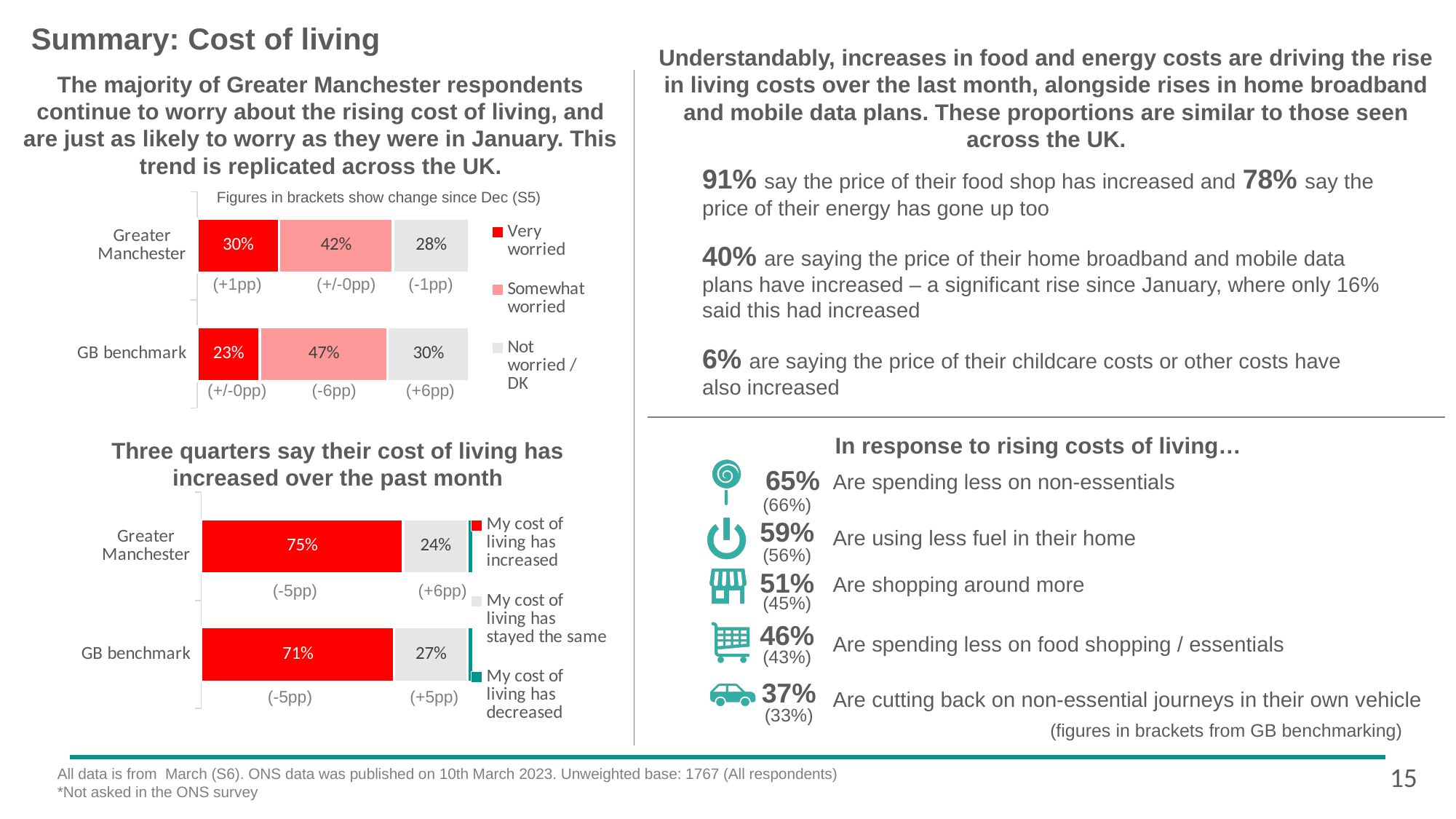
In the bottom-left chart on cost of living increasing over the past month, what is the difference between the 'increased' values for Greater Manchester and the GB benchmark? 4 percentage points In the bottom-left chart on cost of living increasing over the past month, what percentage of Greater Manchester respondents say their cost of living has increased? 75% In the top-left chart on worry about the cost of living, how many series does the legend list? 3 In the top-left chart on worry about the cost of living, what is the total of the Greater Manchester stacked bar? 100% In the top-left chart on worry about the cost of living, what is the difference between the very worried values for Greater Manchester and the GB benchmark? 7 percentage points In the top-left chart on worry about the cost of living, what percentage of Greater Manchester respondents are very worried? 30% In the bottom-left chart on cost of living increasing over the past month, what percentage of the GB benchmark say their cost of living has stayed the same? 27% In the top-left chart on worry about the cost of living, what percentage of the GB benchmark are somewhat worried? 47% In the top-left chart on worry about the cost of living, which has the larger somewhat worried value, Greater Manchester or the GB benchmark? GB benchmark What type of chart is the bottom-left chart on cost of living increasing over the past month? Stacked bar chart In the top-left chart on worry about the cost of living, what is the not worried / DK value for Greater Manchester? 28% In the top-left chart on worry about the cost of living, what does the note above the bars say the figures in brackets show? Change since Dec (S5)